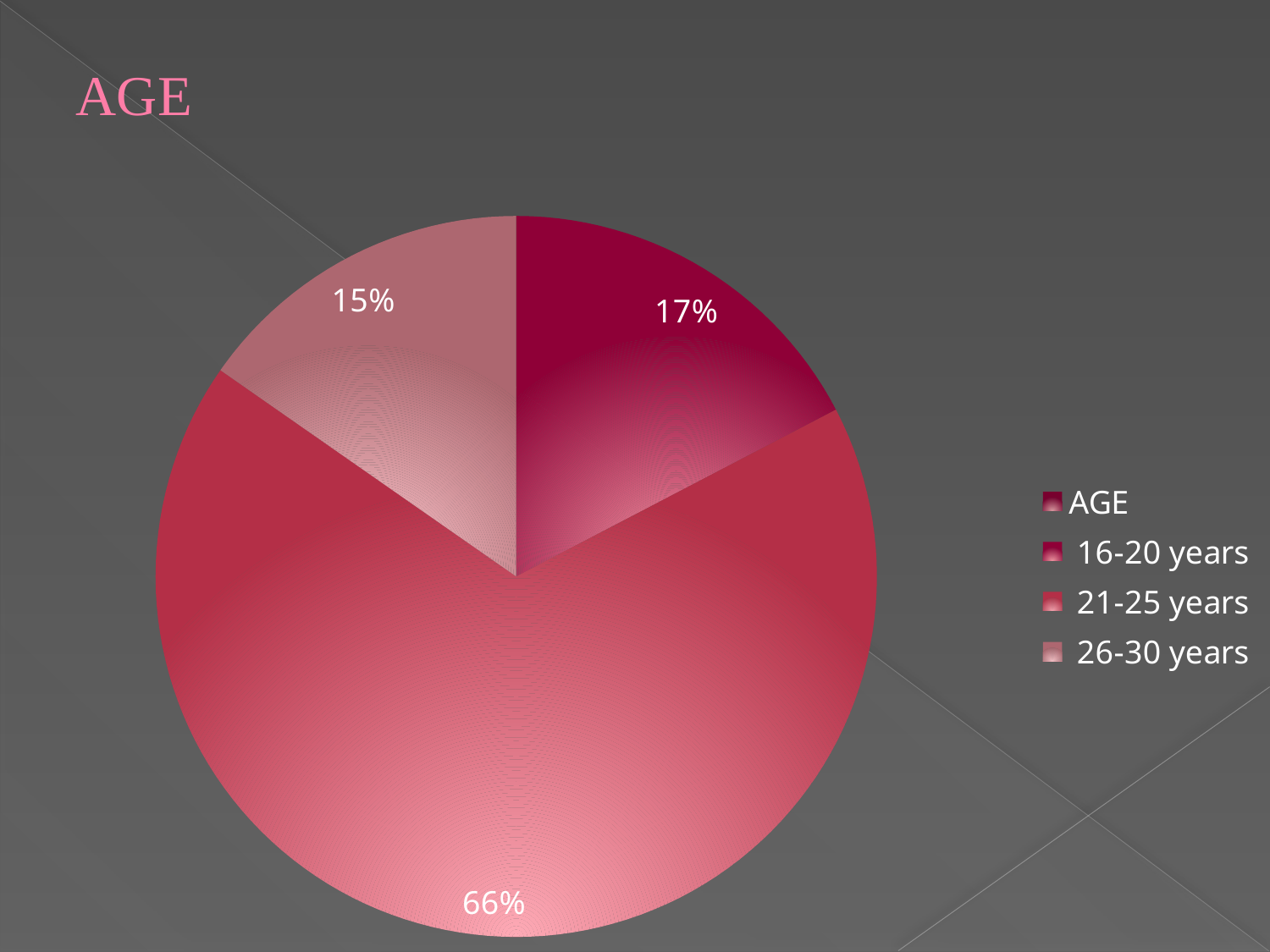
What kind of chart is shown on the slide? pie chart How many slices does the pie chart have? 3 What is the chart's title? AGE What is the difference in percentage points between the 21-25 years slice and the 26-30 years slice? 51% Which is larger, the 21-25 years slice or the 26-30 years slice? 21-25 years What percentage is shown for the 21-25 years slice? 66% Is the share for 21-25 years greater or less than 50%? greater How many entries does the legend list? 4 Which age group has the smallest slice of the pie? 26-30 years Which age group has the largest slice of the pie? 21-25 years What percentage is shown for the 26-30 years slice? 15% What is the difference in percentage points between the two smallest slices of the pie? 2%